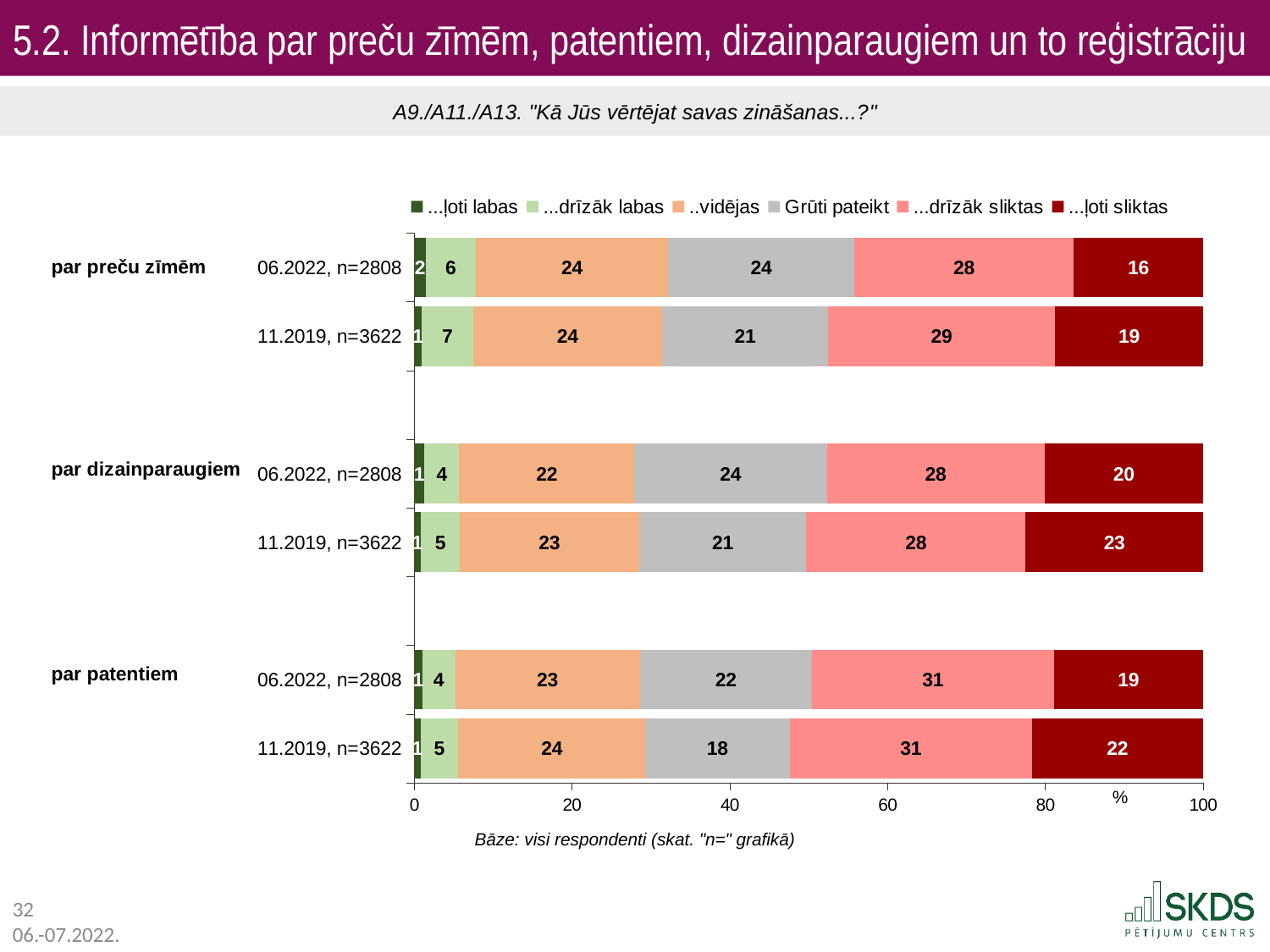
How many bars are plotted in the chart? 6 What is the difference between the "...ļoti sliktas" values for "par dizainparaugiem" in 11.2019, n=3622 and 06.2022, n=2808? 3 What is the value of "...ļoti sliktas" for "par preču zīmēm" in 06.2022, n=2808? 16 What type of chart is shown on the slide? stacked bar chart Which bar has the highest "...ļoti sliktas" value? par dizainparaugiem, 11.2019, n=3622 What is the value of "...drīzāk sliktas" for "par patentiem" in 11.2019, n=3622? 31 What is the question text shown above the chart? A9./A11./A13. "Kā Jūs vērtējat savas zināšanas...?" What is the value of "...drīzāk labas" for "par preču zīmēm" in 11.2019, n=3622? 7 Which is larger: the "Grūti pateikt" value for "par patentiem" in 06.2022, n=2808 or in 11.2019, n=3622? 06.2022, n=2808 Which bar has the lowest "...ļoti sliktas" value? par preču zīmēm, 06.2022, n=2808 How many series does the legend list? 6 What is the value of "Grūti pateikt" for "par dizainparaugiem" in 06.2022, n=2808? 24